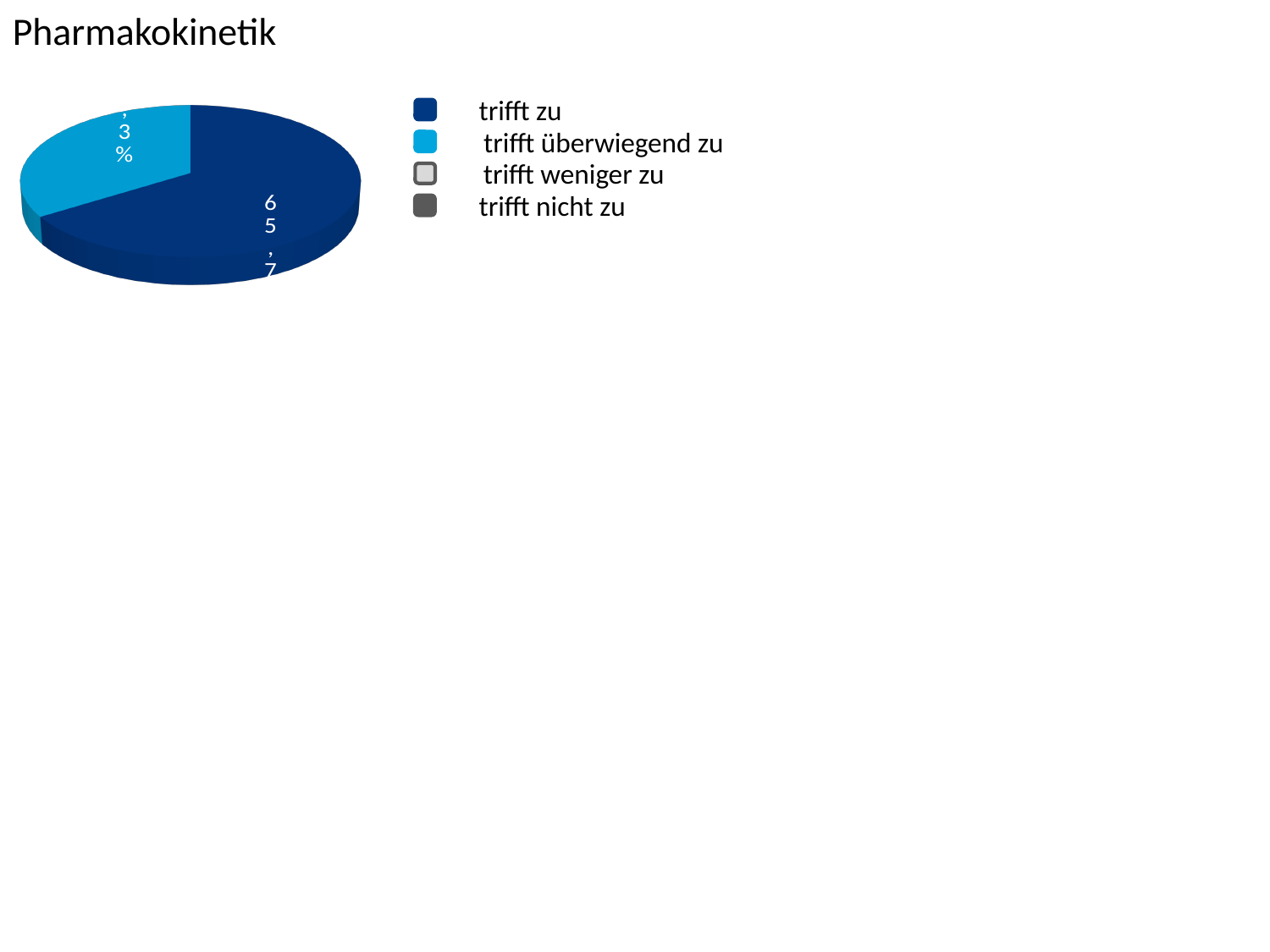
How many slices are visible in the pie chart? 2 How many entries does the legend of the pie chart list? 4 What kind of chart is shown on the slide? pie chart Which legend entry is listed last in the pie chart legend? trifft nicht zu Which category has the largest slice in the pie chart? trifft zu Which slice is larger in the pie chart, 'trifft zu' or 'trifft überwiegend zu'? trifft zu Which colour represents 'trifft zu' in the pie chart legend? dark blue What is the title of the slide with the pie chart? Pharmakokinetik